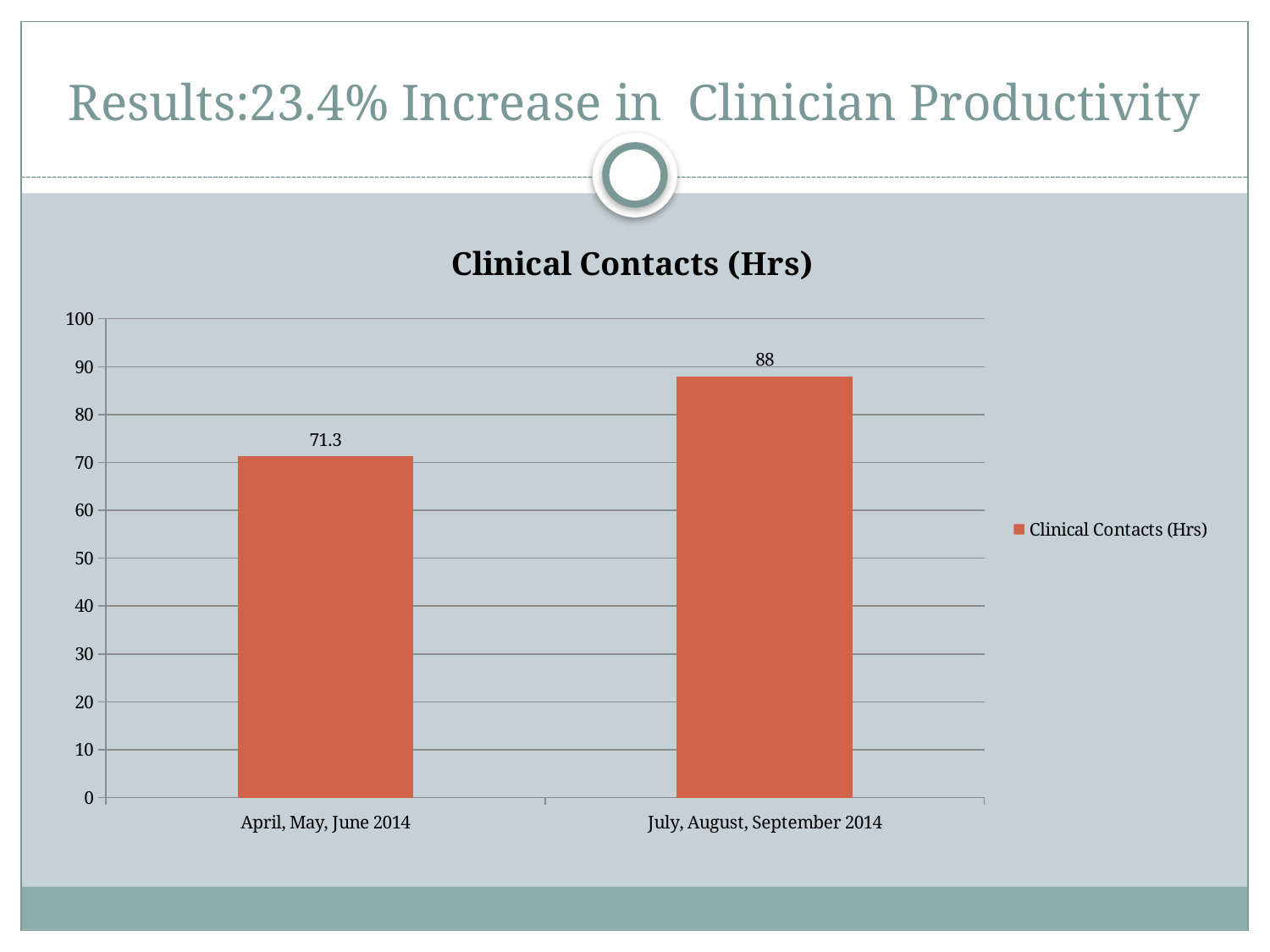
Which is larger: the value for April, May, June 2014 or July, August, September 2014? July, August, September 2014 What kind of chart is shown? bar chart How many categories are shown on the x axis? 2 Is the value for July, August, September 2014 greater or less than 80? greater Which period has the lowest Clinical Contacts (Hrs)? April, May, June 2014 What is the difference between the values for July, August, September 2014 and April, May, June 2014? 16.7 How many series does the legend list? 1 What is the title of the chart? Clinical Contacts (Hrs) Which period has the highest Clinical Contacts (Hrs)? July, August, September 2014 Is the value for April, May, June 2014 greater or less than 80? less What is the value for July, August, September 2014? 88 What is the value for April, May, June 2014? 71.3